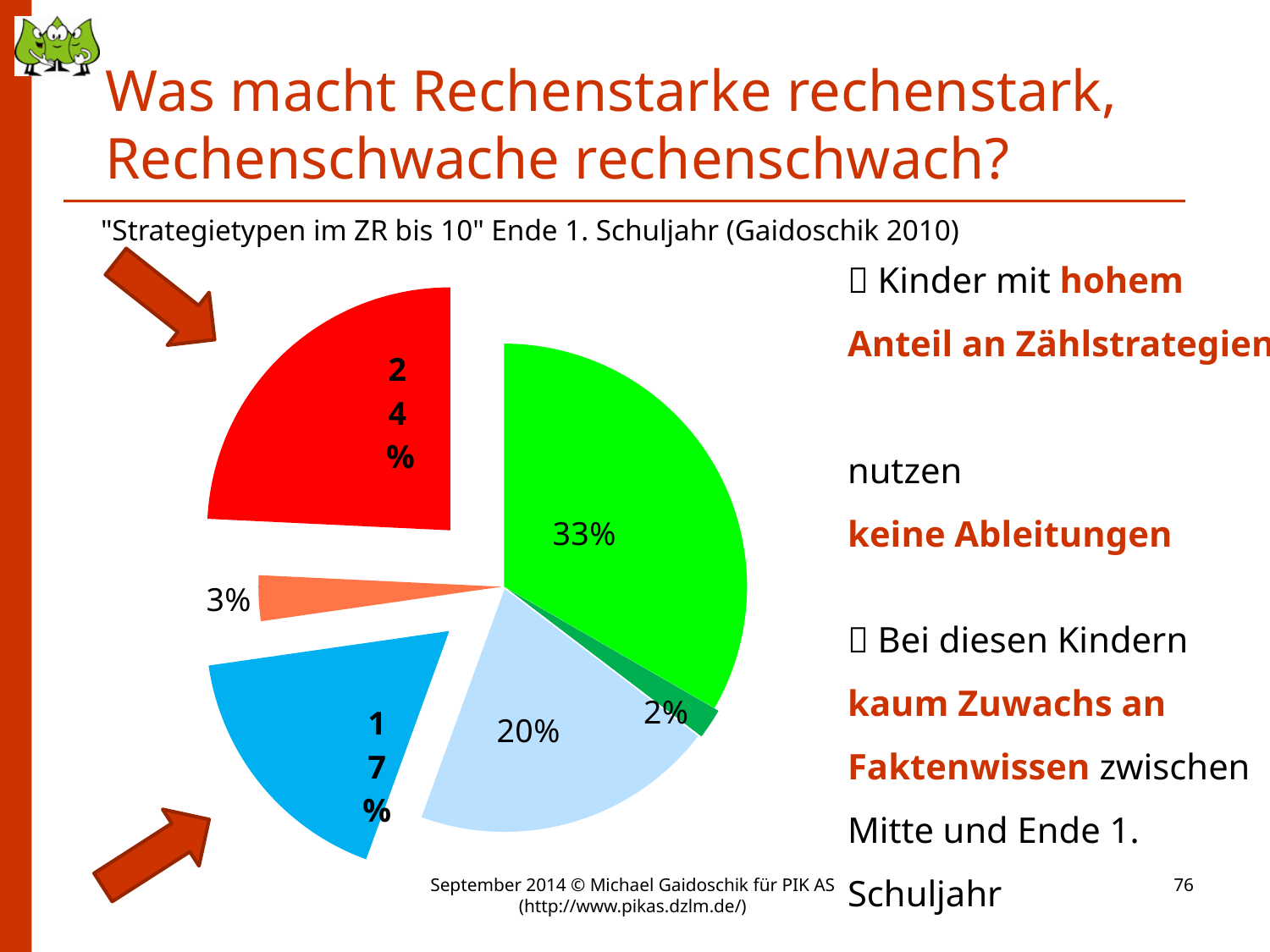
What kind of chart is shown on the slide? pie chart What percentage is shown on the small orange slice of the pie chart? 3% What is the difference in percentage points between the green slice (33%) and the red slice (24%)? 9 What percentage is shown on the red slice of the pie chart? 24% How many slices does the pie chart have? 6 What percentage is shown on the light blue slice of the pie chart? 20% What is the largest slice of the pie chart? 33% What colour is the largest slice of the pie chart? green Which slice is larger, the light blue slice or the blue slice? the light blue slice (20%) What is the title of the chart on the slide? "Strategietypen im ZR bis 10" Ende 1. Schuljahr (Gaidoschik 2010) What percentage is shown on the blue slice at the bottom left of the pie chart? 17% What is the smallest slice of the pie chart? 2%